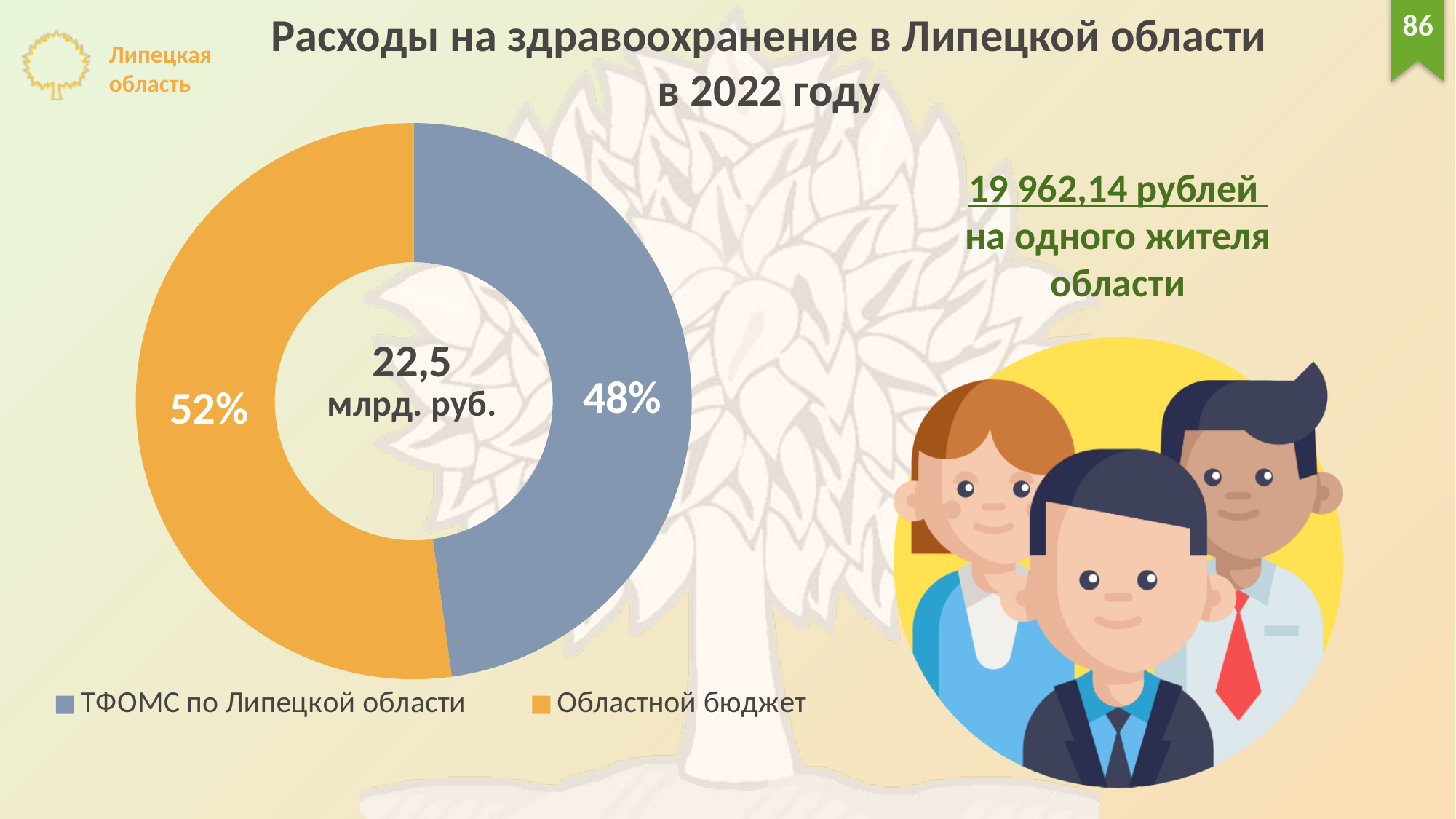
What colour represents Областной бюджет in the chart? Orange Which source has the larger share of healthcare expenditure? Областной бюджет By how many percentage points does the Областной бюджет share exceed the ТФОМС share? 4 Which is larger: the share of ТФОМС по Липецкой области or the share of Областной бюджет? Областной бюджет What share of healthcare expenditure comes from ТФОМС по Липецкой области? 48% What total amount is shown in the centre of the chart? 22,5 млрд. руб. Which source has the smaller share of healthcare expenditure? ТФОМС по Липецкой области What share of healthcare expenditure comes from the Областной бюджет? 52% How many categories does the chart show? 2 What kind of chart is shown on the slide? Pie (doughnut) chart What is the title of the chart on the slide? Расходы на здравоохранение в Липецкой области в 2022 году How many entries does the legend list? 2